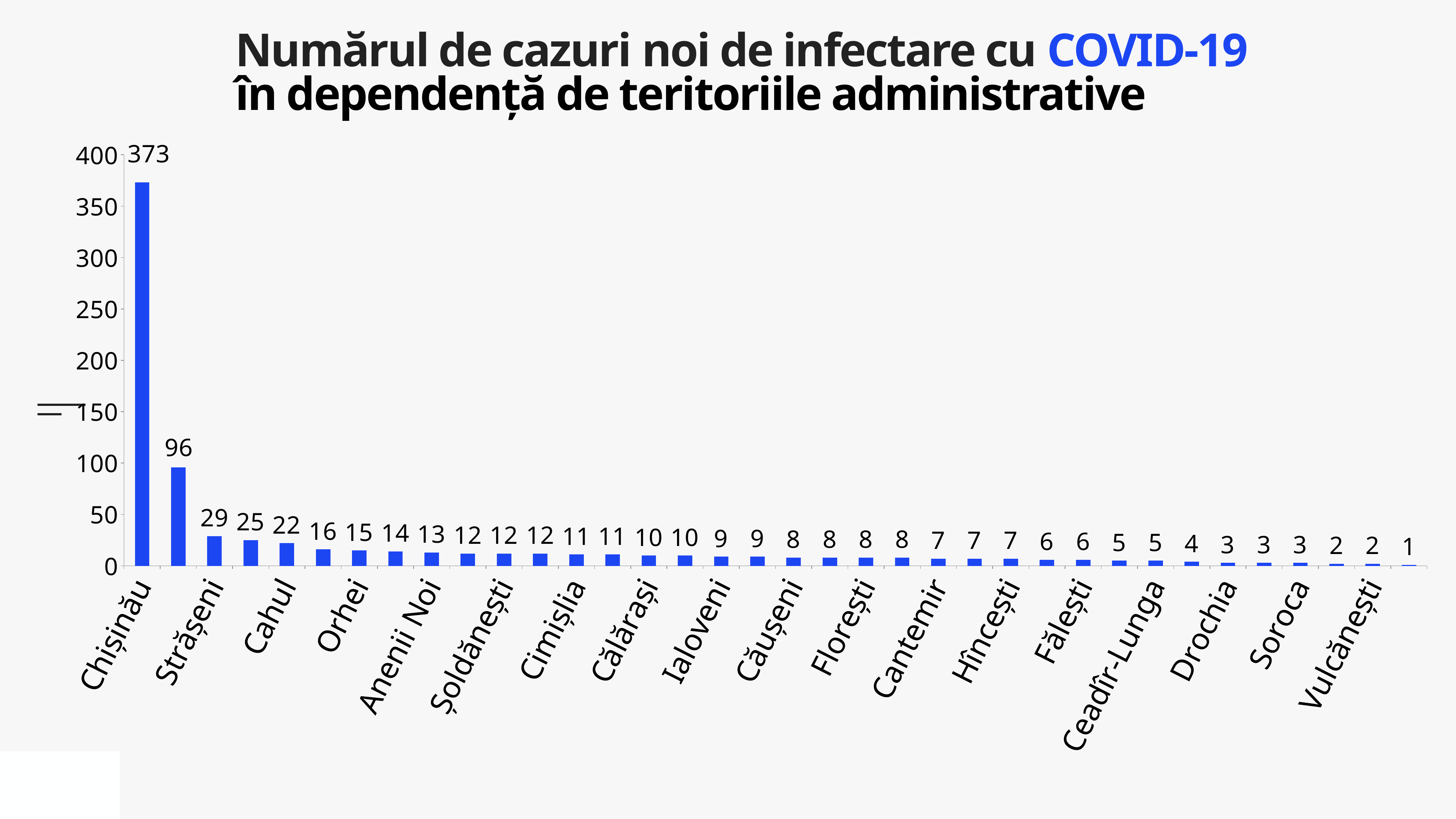
Is the value of the second bar from the left greater or less than 100? less How many new COVID-19 cases are shown for Chișinău? 373 Do the values rise or fall from left to right along the x axis? fall What is the title of the chart? Numărul de cazuri noi de infectare cu COVID-19 în dependență de teritoriile administrative How many bars are plotted on the chart? 36 What colour are the bars on the chart? blue Is the value for Chișinău greater or less than 350? greater What is the difference between the highest bar (373) and the second highest bar (96)? 277 What kind of chart is shown on the slide? bar chart What is the highest value shown on the chart? 373 What is the lowest value shown on the chart? 1 Which territory has the highest number of new COVID-19 cases? Chișinău